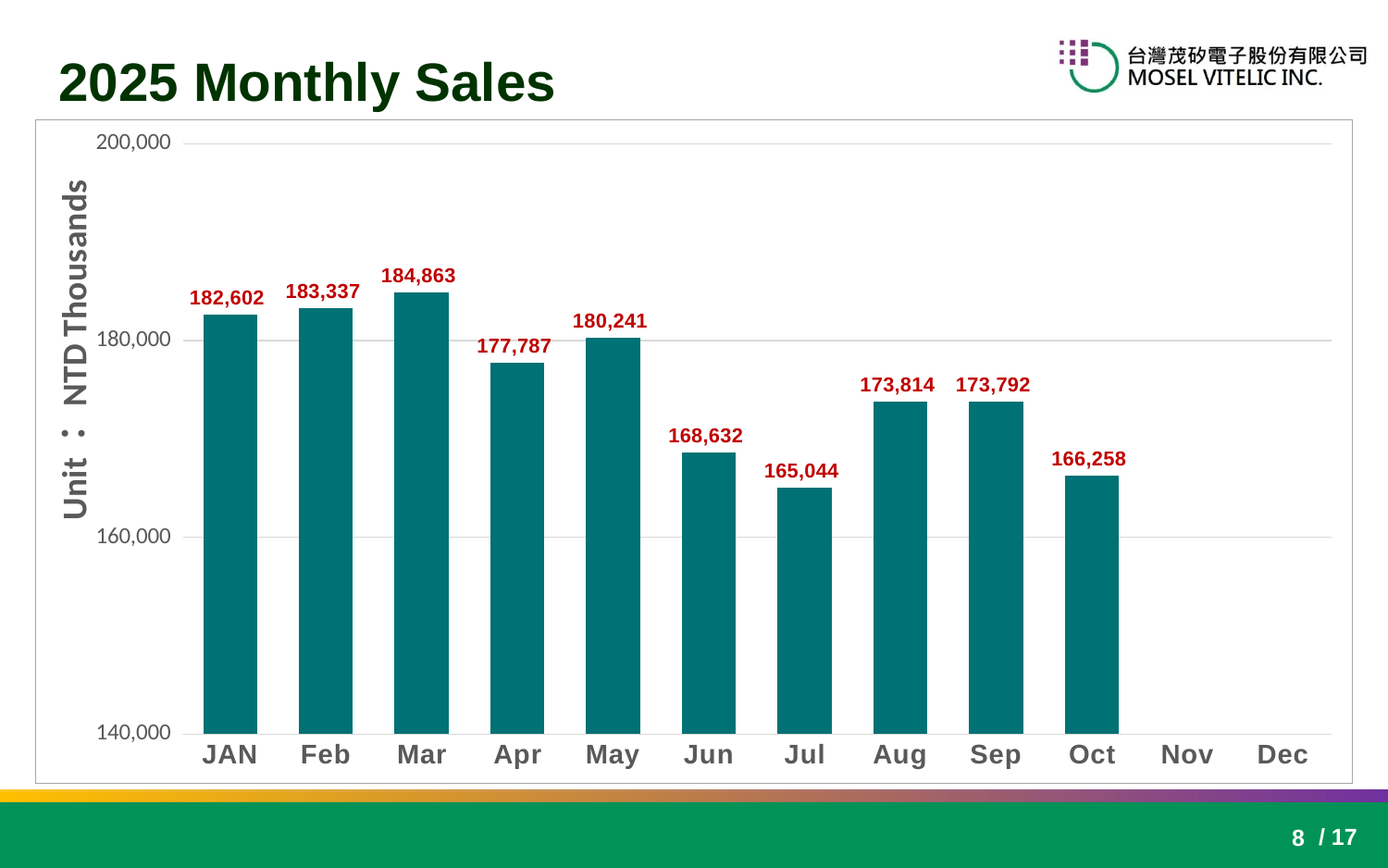
Which month has the lowest sales value among the plotted bars? Jul Which month has the highest sales value? Mar How many months have a bar plotted on the chart? 10 What is the sales value for Mar? 184,863 What is the sales value for Oct? 166,258 What is the sales value for Jul? 165,044 Which is larger, the sales value for Apr or for Jun? Apr What is the difference between the sales values for Mar and Jul? 19,819 Is the value for Apr greater or less than 180,000? less What kind of chart is shown on the slide? bar chart Do the sales values rise or fall from Mar to Jul? fall What is the difference between the sales values for Feb and JAN? 735